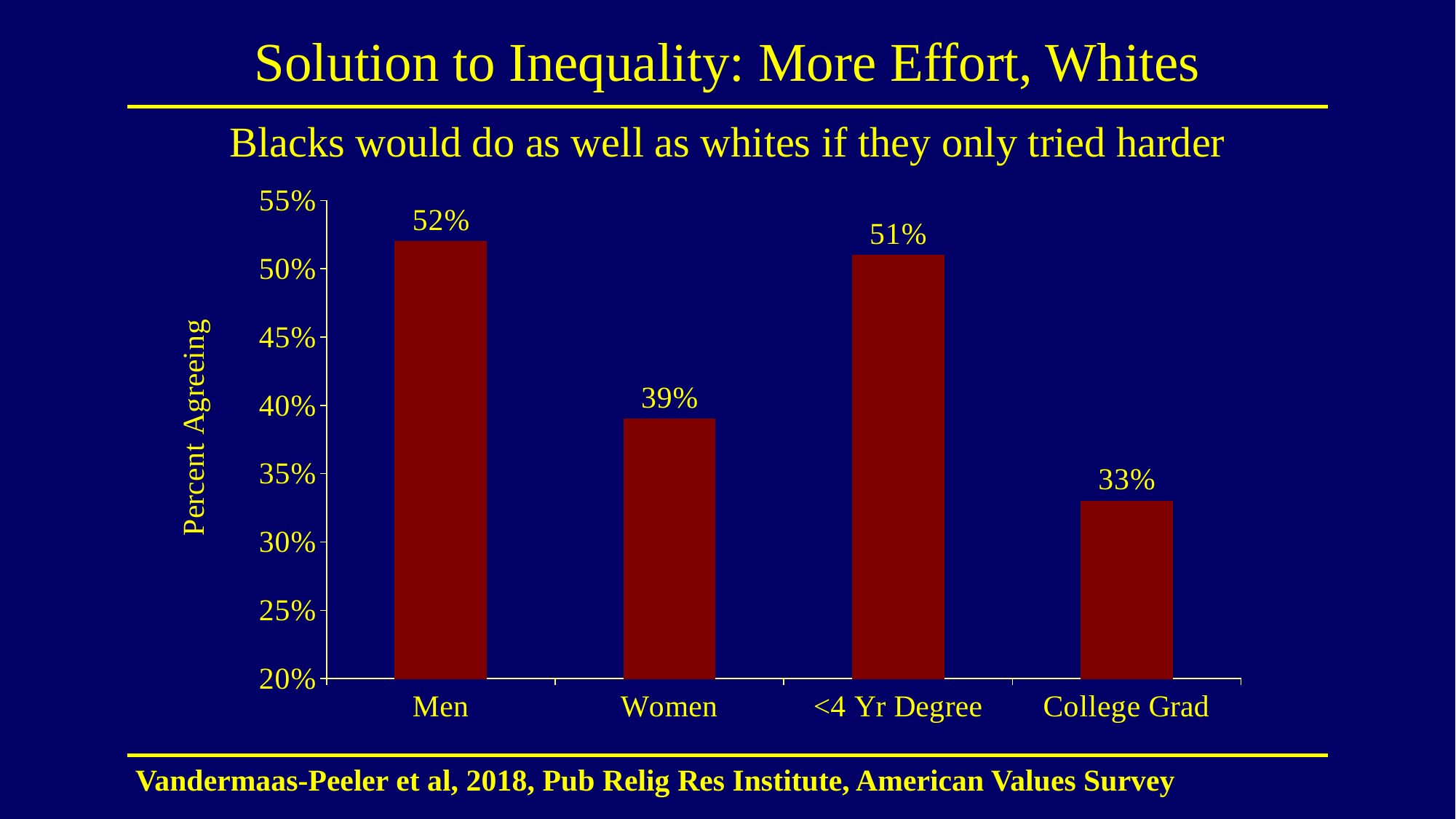
What percent of men agree that Blacks would do as well as whites if they only tried harder? 52% Which category has the highest percent agreeing? Men What is the value for College Grad? 33% Which category has the lowest percent agreeing? College Grad What is the difference in percent agreeing between <4 Yr Degree and College Grad? 18% What kind of chart is shown on the slide? Bar chart What is the difference in percent agreeing between Men and Women? 13% How many categories are shown on the x axis? 4 What is the value for <4 Yr Degree? 51% Which is larger, the value for Women or the value for College Grad? Women What is the label on the y axis? Percent Agreeing What is the value for Women? 39%